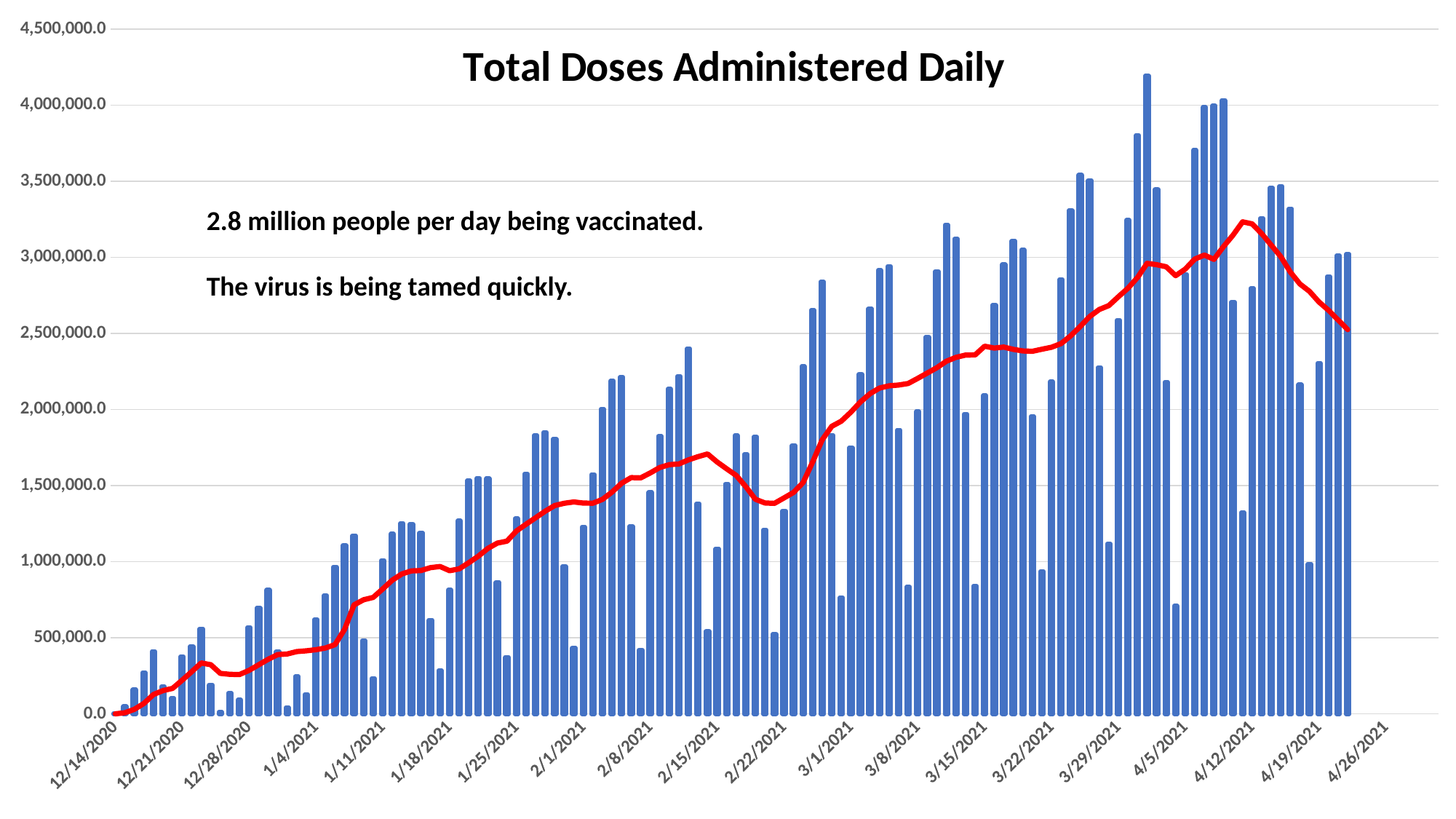
How many date labels are shown on the horizontal axis? 20 What kind of chart is used to show the daily doses? Bar chart with a line overlay What is the title of the chart? Total Doses Administered Daily Overall, do the daily dose values rise or fall from 12/14/2020 to 4/26/2021? Rise What is the highest value shown on the vertical axis? 4,500,000.0 Is the peak of the red line greater or less than 3,000,000? greater Is the tallest bar on the chart greater or less than 4,000,000? greater Is the value of the red line at 2/22/2021 greater or less than 1,500,000? less Does the red line rise or fall between 4/12/2021 and 4/26/2021? Fall What colour is the trend line drawn over the bars? Red